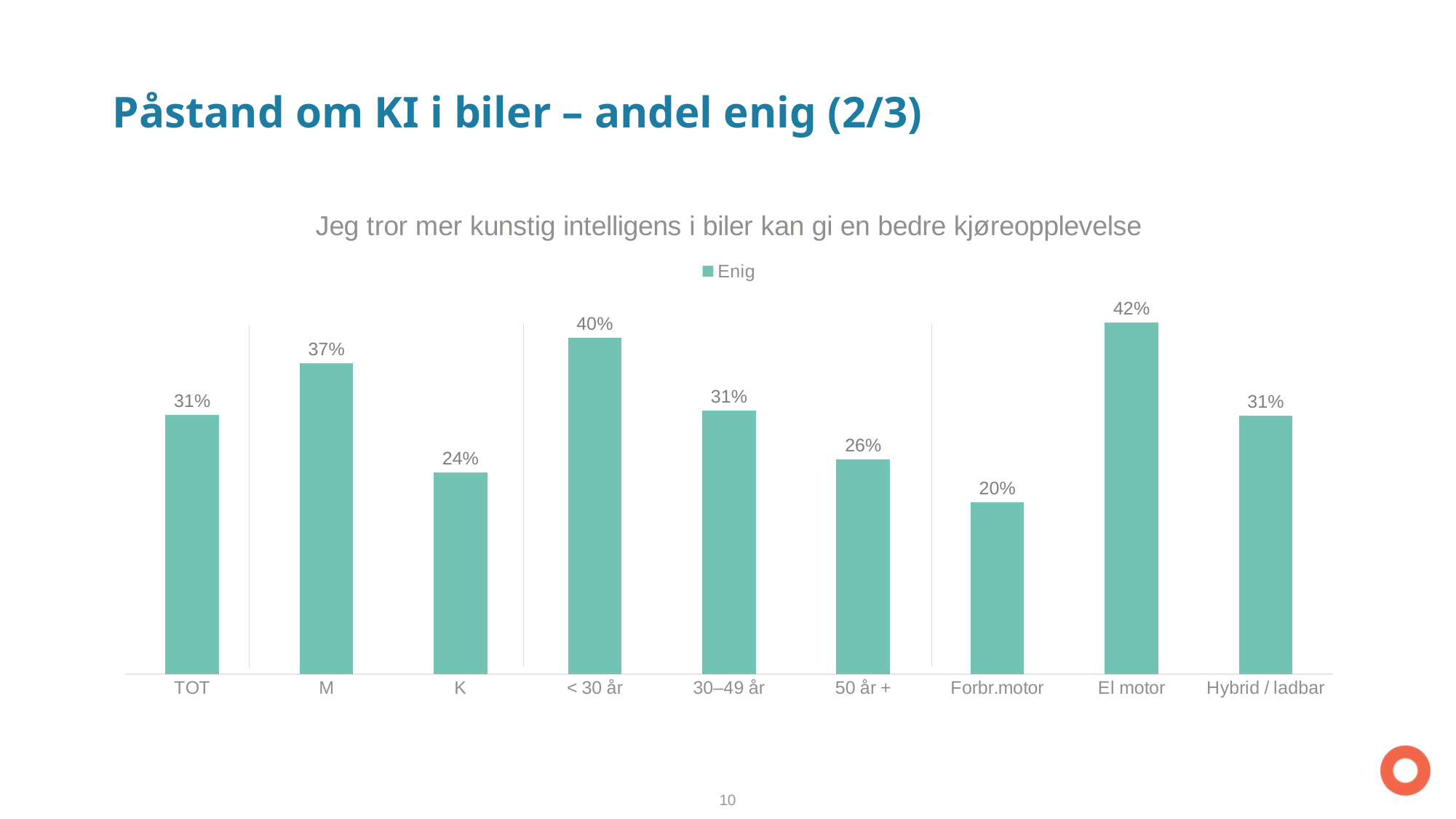
What kind of chart is shown? Bar chart What series name does the legend show? Enig What is the value for TOT? 31% Which is larger, the value for M or the value for Hybrid / ladbar? M What is the difference between the values for M and K? 13% What is the value for El motor? 42% Which category has the lowest value? Forbr.motor How many categories are shown on the x axis? 9 Which category has the highest value? El motor What is the value for < 30 år? 40% What is the difference between the values for < 30 år and 50 år +? 14% What is the value for Forbr.motor? 20%